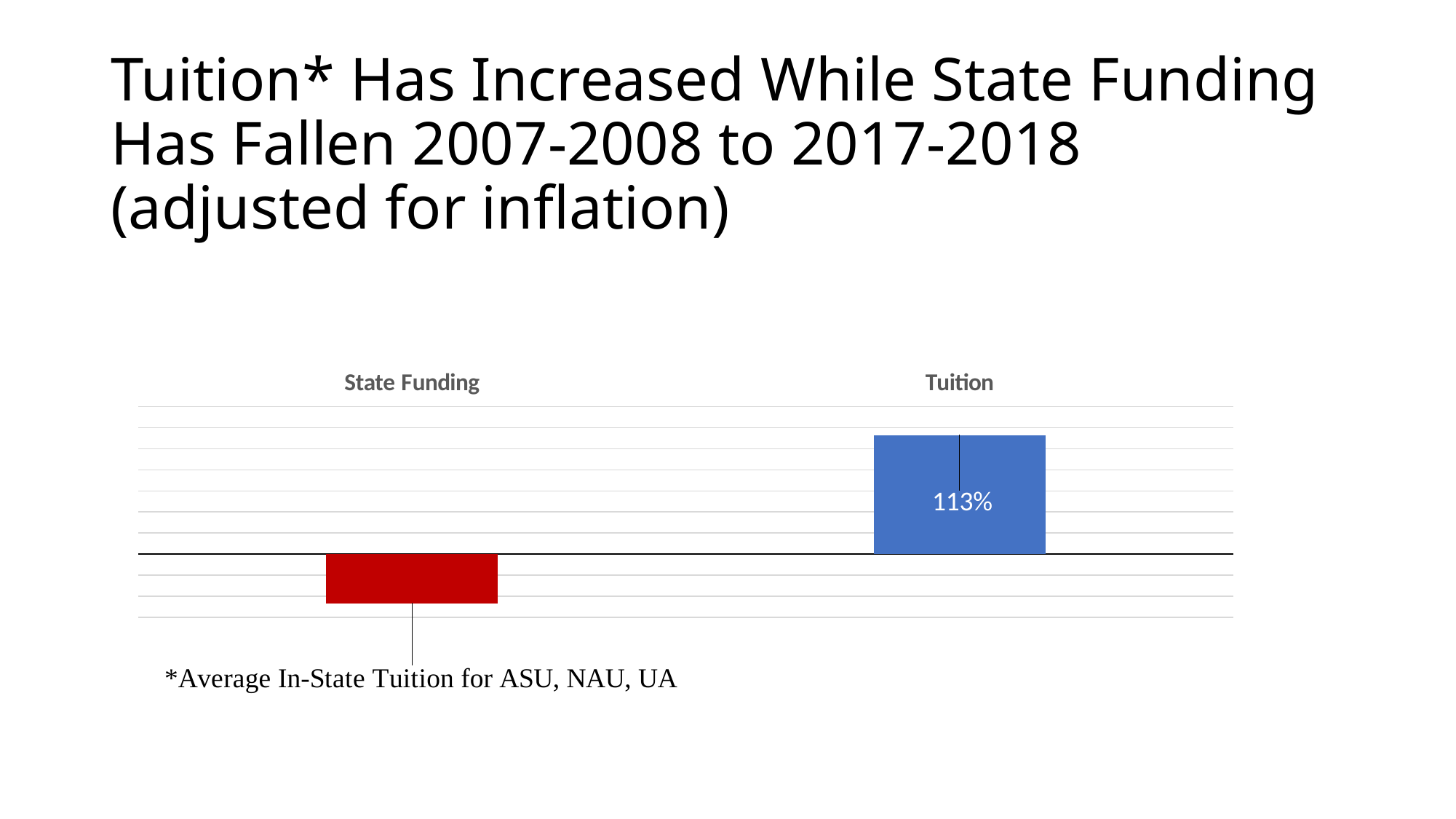
What colour is the Tuition bar? Blue How many categories are shown in the chart? 2 What value is shown for Tuition? 113% Which is larger, the value for Tuition or the value for State Funding? Tuition Which category has the highest value? Tuition Is the State Funding bar above or below the zero line? Below Which category has the lowest value? State Funding What kind of chart is shown on the slide? Bar chart